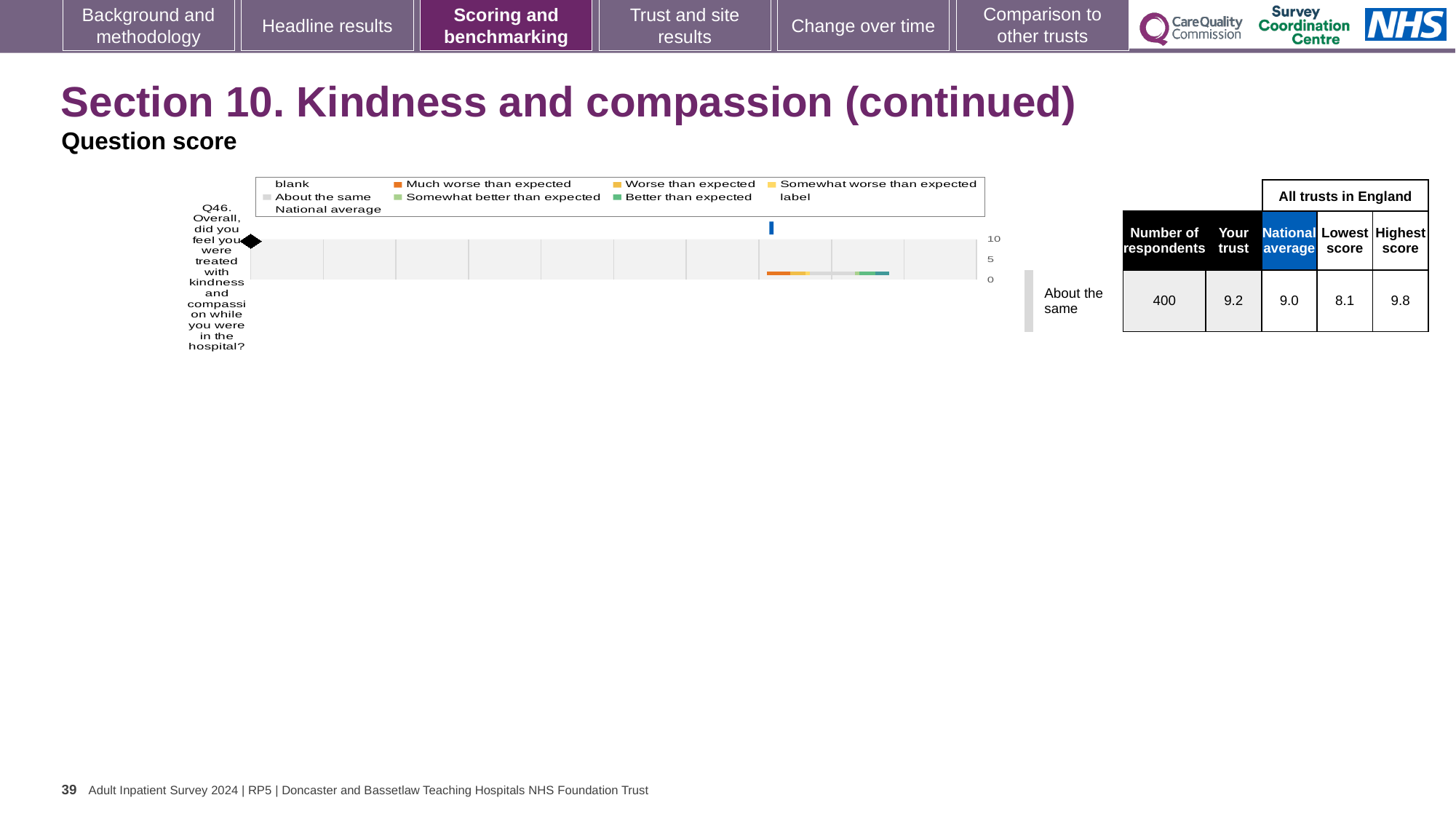
What colour does the legend use for 'Much worse than expected'? orange According to the table next to the chart, is the 'Your trust' score or the national average score larger for Q46? Your trust In the table next to the chart, what is the lowest score among all trusts in England for Q46? 8.1 What kind of chart is shown on the slide for Q46? bar chart In the table next to the chart, what is the national average score for Q46? 9.0 In the table next to the chart, what is the number of respondents for Q46? 400 How many question categories are plotted on the chart? 1 According to the table next to the chart, what is the difference between the highest score and the lowest score for Q46? 1.7 In the table next to the chart, what is the 'Your trust' score for Q46? 9.2 What is the highest value shown on the chart's axis? 10 In the table next to the chart, what is the highest score among all trusts in England for Q46? 9.8 Which question is plotted on the chart? Q46. Overall, did you feel you were treated with kindness and compassion while you were in the hospital?